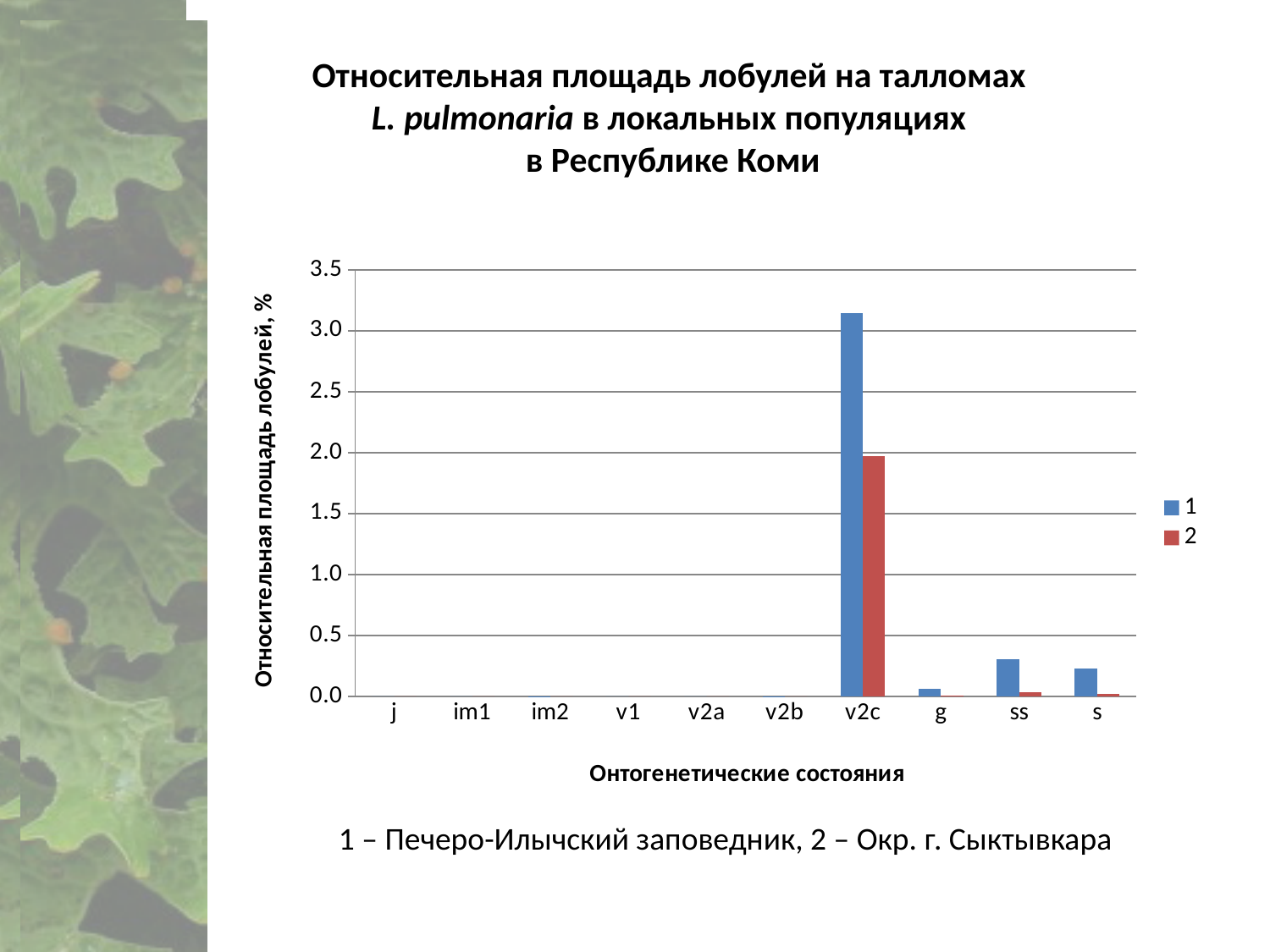
Is the value for series 1 at v2c greater or less than 3.0? greater Is the value for series 2 at v2c greater or less than 2.5? less Is the value for series 1 at ss greater or less than 0.5? less Which category has the highest value for series 1? v2c For series 1, which category has the larger value, ss or s? ss What is the title of the x axis of the chart? Онтогенетические состояния What kind of chart is shown on the slide? bar chart Which category has the highest value for series 2? v2c How many categories are shown on the x axis of the chart? 10 For the category v2c, which series has the larger value, 1 or 2? 1 How many series does the chart legend list? 2 What is the title of the y axis of the chart? Относительная площадь лобулей, %